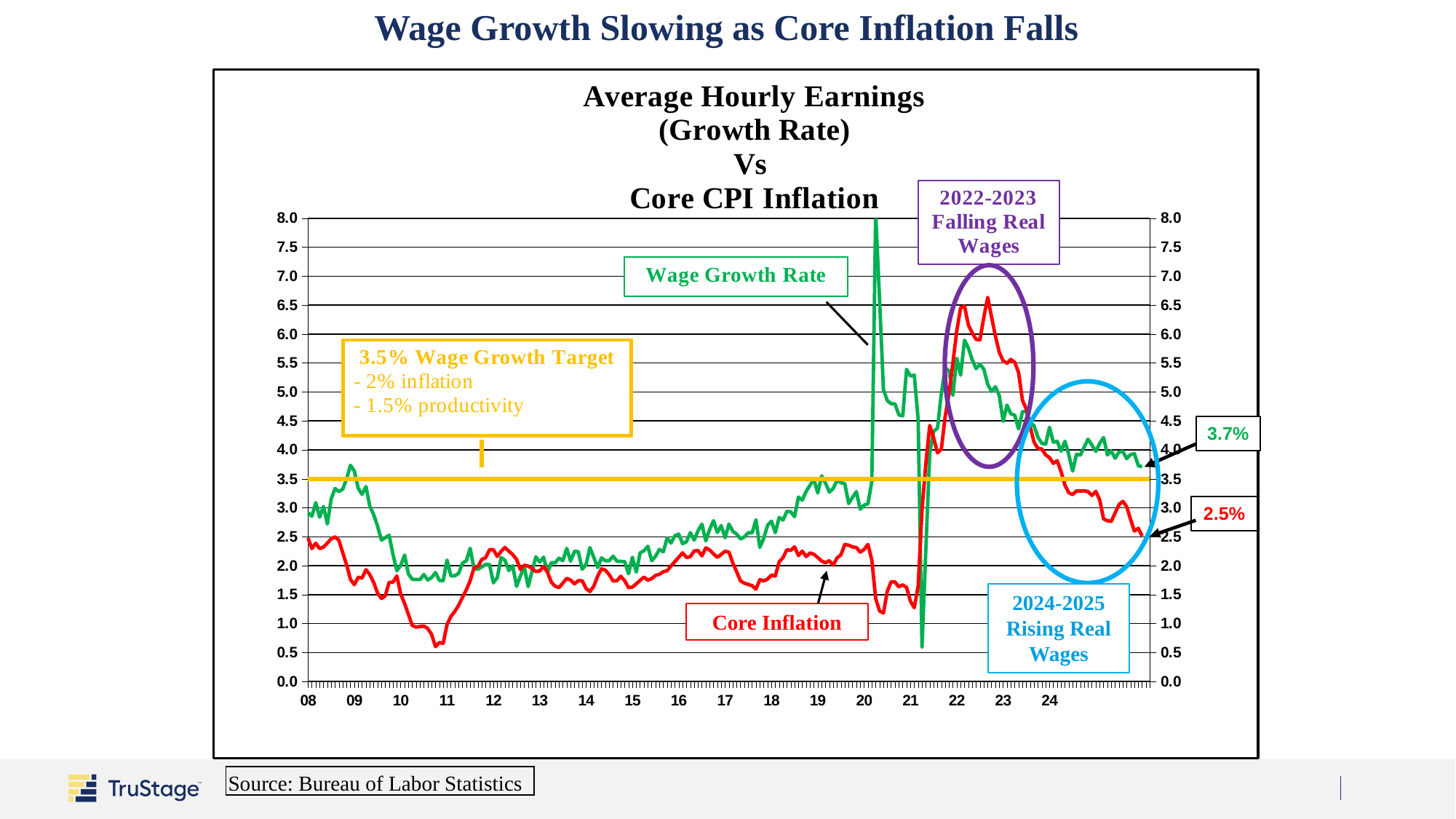
What is the difference between the latest labeled Wage Growth Rate (3.7%) and the latest labeled Core Inflation (2.5%)? 1.2% What is the latest labeled value of the Wage Growth Rate line? 3.7% What kind of chart is shown on the slide? line chart Does the Wage Growth Rate line rise or fall from 2022 to 2024? fall How many data series are labeled on the chart (excluding the target line)? 2 At the right end of the chart, which is higher: the Wage Growth Rate or Core Inflation? Wage Growth Rate What value is the yellow horizontal Wage Growth Target line set at? 3.5% Is the peak of the Wage Growth Rate line around 2020 greater or less than 7.0? greater What is the latest labeled value of the Core Inflation line? 2.5% Which series reaches the highest value anywhere on the chart? Wage Growth Rate What period and condition does the purple ellipse on the chart mark? 2022-2023 Falling Real Wages Is the lowest point of the Core Inflation line around 2010-2011 greater or less than 1.0? less